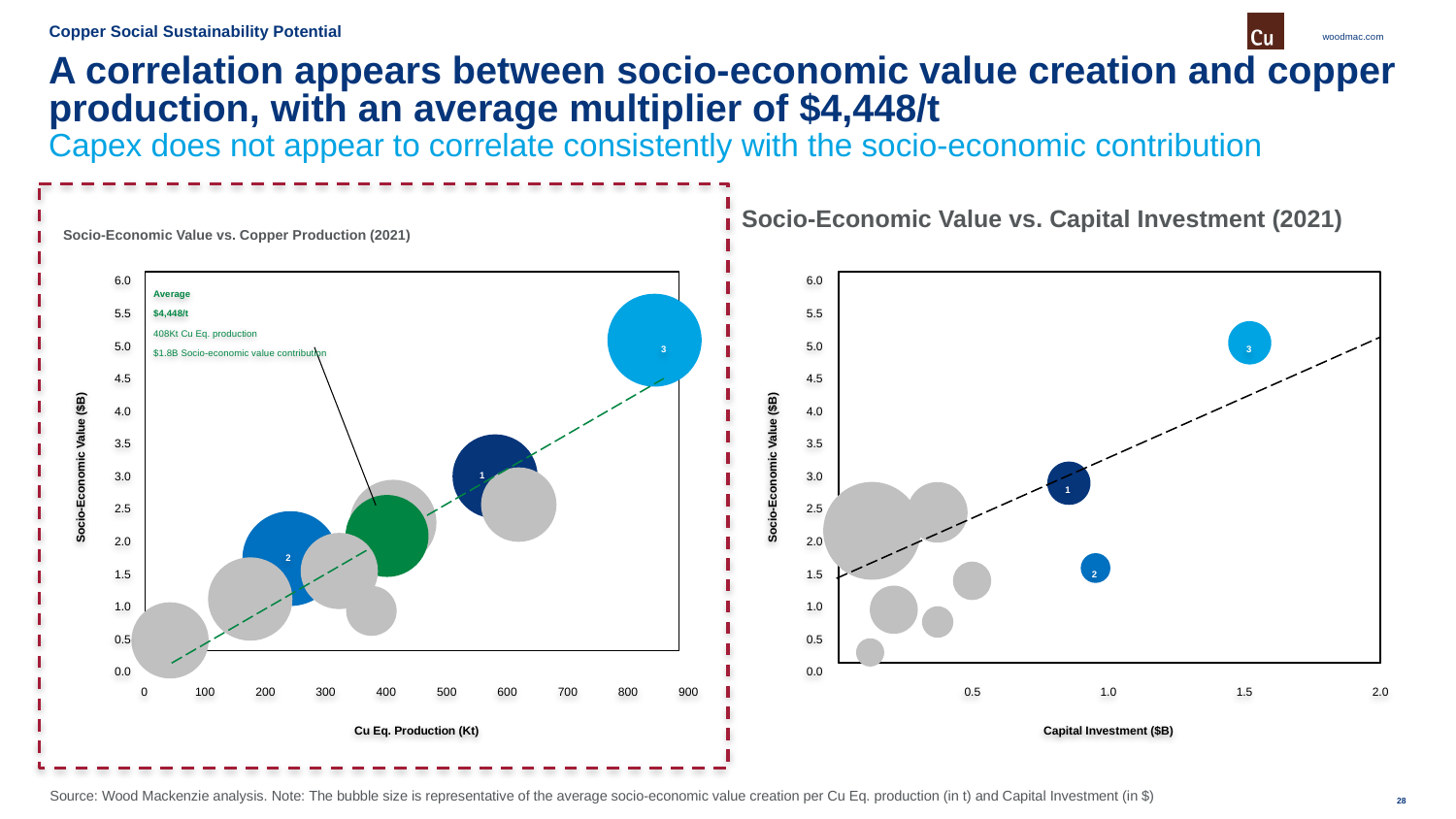
On the left chart, 'Socio-Economic Value vs. Copper Production (2021)', what average socio-economic value contribution is annotated? $1.8B On the left chart, 'Socio-Economic Value vs. Copper Production (2021)', which of the numbered bubbles has the lowest socio-economic value? 2 On the left chart, 'Socio-Economic Value vs. Copper Production (2021)', is the socio-economic value for bubble 2 greater or less than 2.0 $B? less On the right chart, 'Socio-Economic Value vs. Capital Investment (2021)', what is the x-axis label? Capital Investment ($B) On the right chart, 'Socio-Economic Value vs. Capital Investment (2021)', is the capital investment for bubble 3 greater or less than 1.0 $B? greater On the right chart, 'Socio-Economic Value vs. Capital Investment (2021)', is the socio-economic value for bubble 2 greater or less than 2.0 $B? less On the left chart, 'Socio-Economic Value vs. Copper Production (2021)', what average multiplier is annotated? $4,448/t On the left chart, 'Socio-Economic Value vs. Copper Production (2021)', which of the numbered bubbles has the highest socio-economic value? 3 On the left chart, 'Socio-Economic Value vs. Copper Production (2021)', what average Cu Eq. production is annotated? 408Kt What kind of chart is the left chart, 'Socio-Economic Value vs. Copper Production (2021)'? Bubble chart